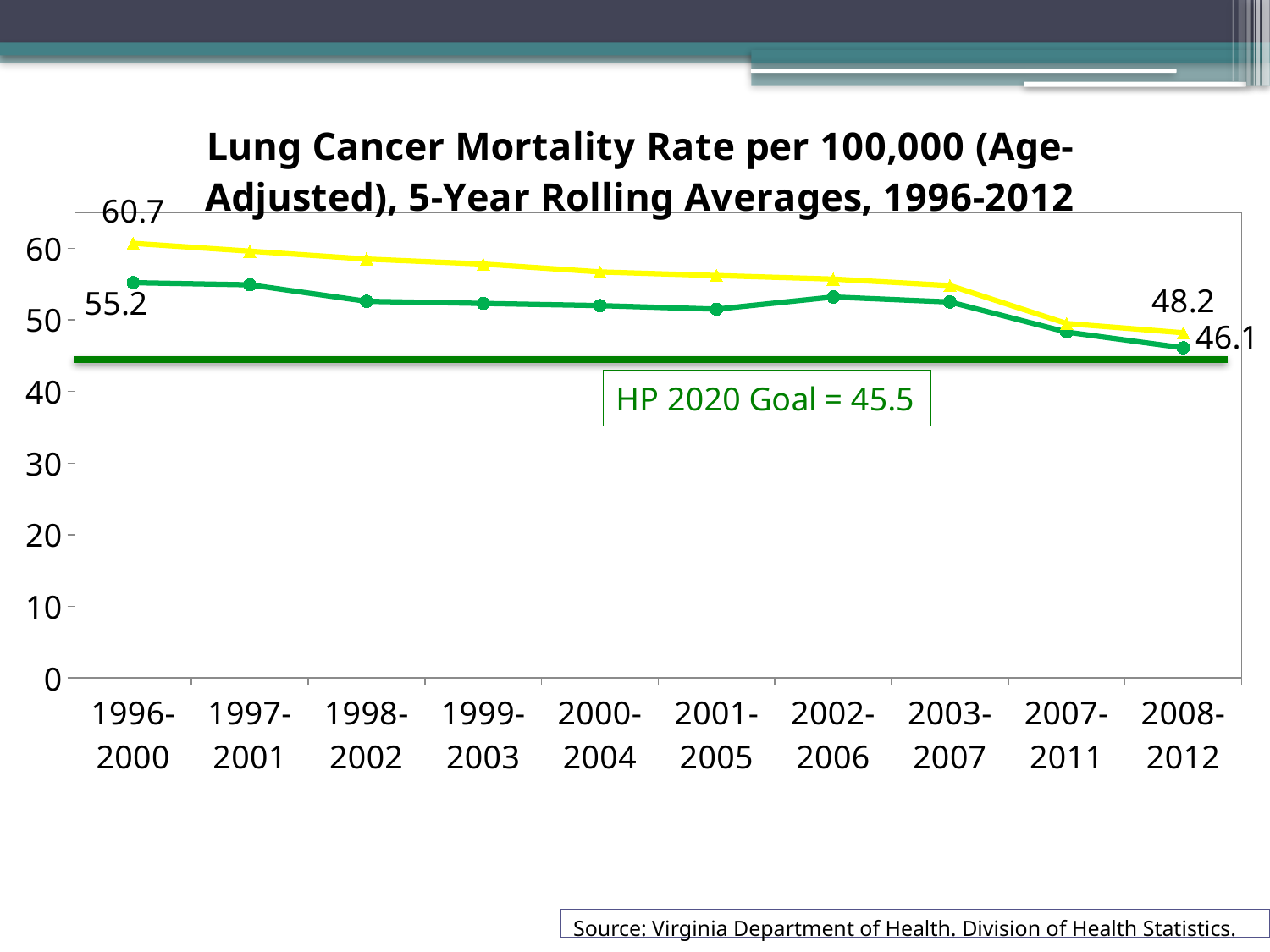
What is the value of the yellow line for 1996-2000? 60.7 Is the value of the green line for 2003-2007 greater or less than 50? greater Which line has the higher value for 1996-2000, the yellow line or the green line? yellow line What is the value of the yellow line for 2008-2012? 48.2 By how much did the yellow line fall from 1996-2000 to 2008-2012? 12.5 What is the value of the green line for 1996-2000? 55.2 What is the difference between the yellow and green lines for 2008-2012? 2.1 What kind of chart is shown on the slide? line chart Do the values of the yellow line rise or fall from 1996-2000 to 2008-2012? fall What is the value of the green line for 2008-2012? 46.1 How many time periods are shown on the x axis? 10 What is the HP 2020 Goal shown on the chart? 45.5